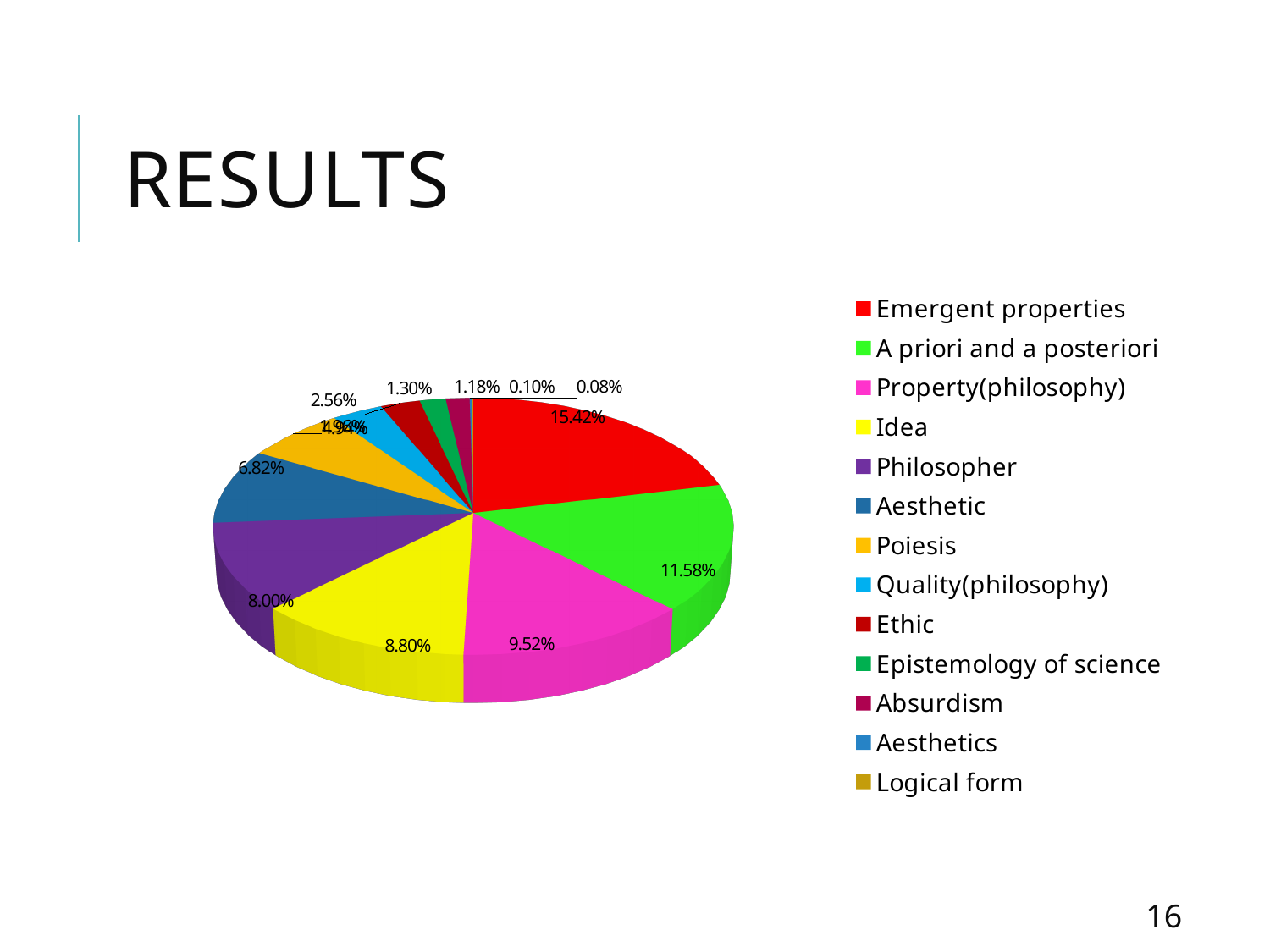
What percentage is shown for Philosopher? 8.00% What percentage is shown for A priori and a posteriori? 11.58% What is the difference between the percentages for Emergent properties and A priori and a posteriori? 3.84% What percentage is shown for Idea? 8.80% What kind of chart is shown on the slide? pie chart What percentage is shown for Aesthetic? 6.82% Which category has the largest slice of the pie? Emergent properties Which has a larger share, Idea or Philosopher? Idea How many categories does the legend of the pie chart list? 13 What percentage is shown for Property(philosophy)? 9.52% What is the title of the slide containing the pie chart? RESULTS What percentage is shown for Emergent properties? 15.42%